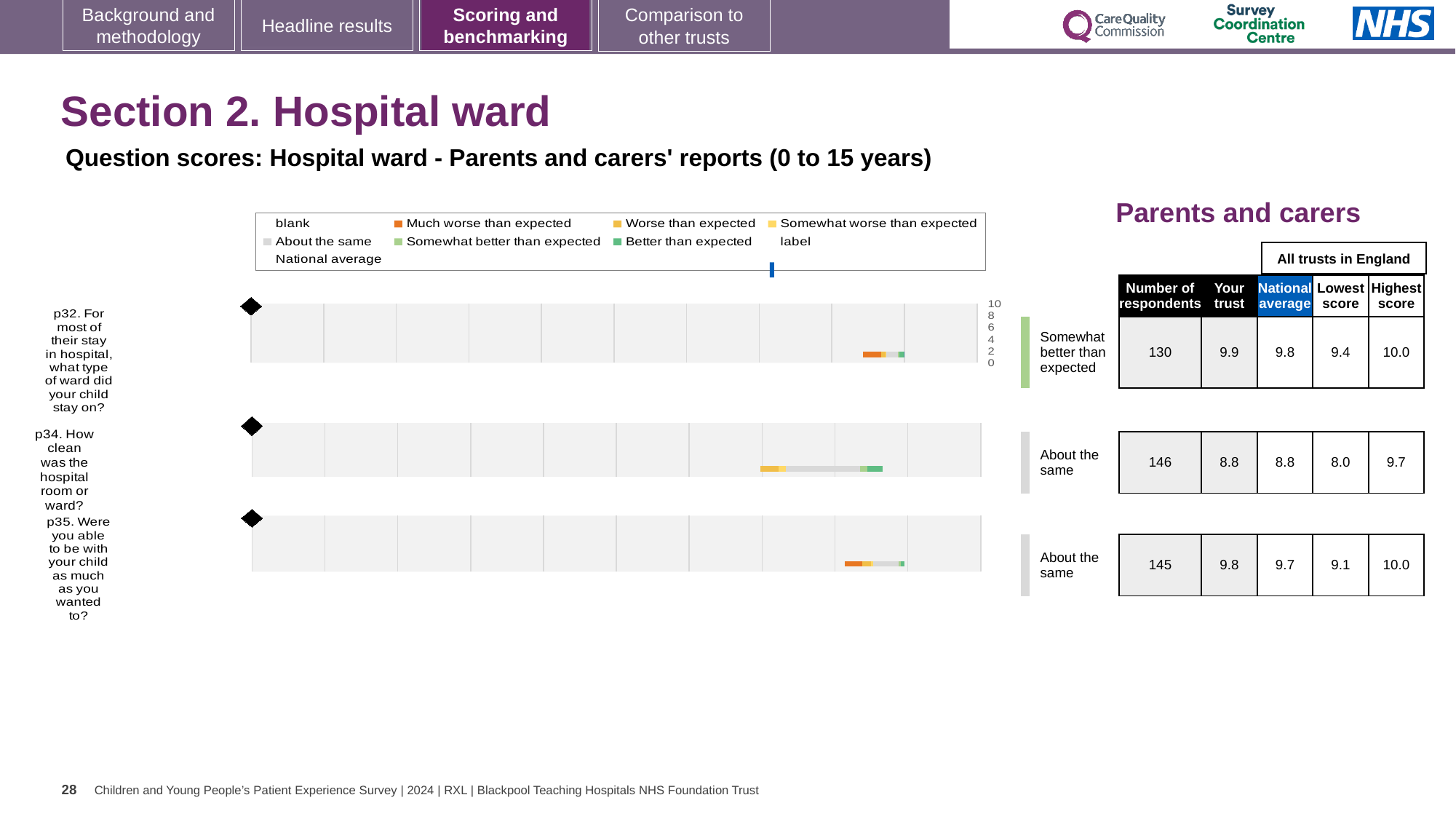
What kind of chart is used to show the question scores on this slide? Bar chart What is the difference between the 'Your trust' score and the national average for p32? 0.1 What colour is 'Better than expected' shown as in the chart legend? Green Which question has the lowest 'Your trust' score? p34 Which benchmark category is p32 placed in? Somewhat better than expected How many questions (categories) are plotted in the chart? 3 What is the highest score among all trusts in England for p34? 9.7 In the chart legend, what does the blue marker represent? National average What is the number of respondents for p32 (what type of ward did your child stay on)? 130 Which question has the highest 'Your trust' score? p32 What is the 'Your trust' score for p34 (how clean was the hospital room or ward)? 8.8 What is the national average score for p35 (were you able to be with your child as much as you wanted to)? 9.7